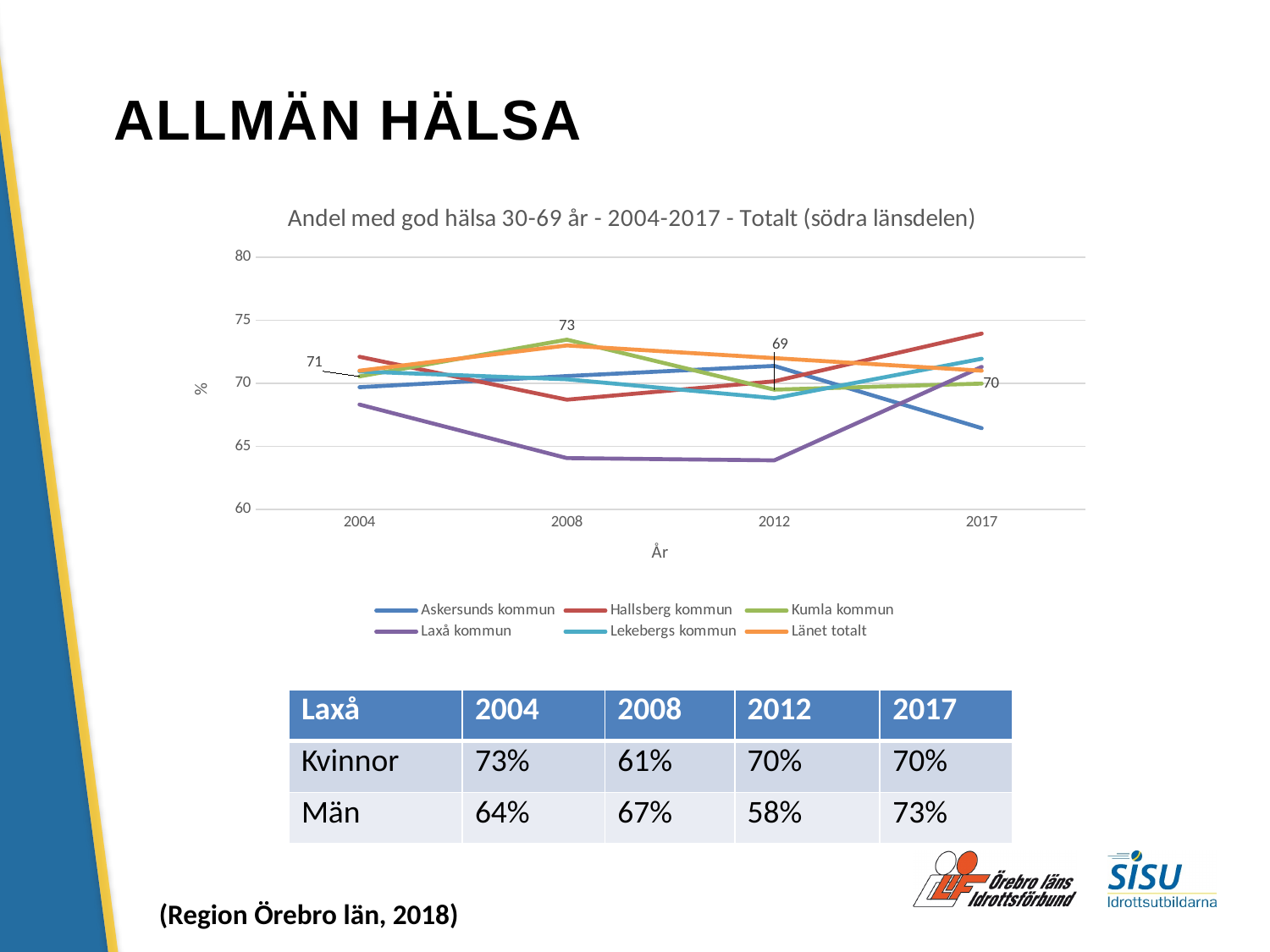
How many series does the chart legend list? 6 Is the value for Laxå kommun in 2012 greater or less than 65? less What is the labelled value for Kumla kommun in 2008? 73 Which series has the lowest value in 2008? Laxå kommun What type of chart is shown on the slide? Line chart What is the labelled value for Kumla kommun in 2012? 69 What is the labelled value for Kumla kommun in 2004? 71 What is the title of the chart? Andel med god hälsa 30-69 år - 2004-2017 - Totalt (södra länsdelen) How many years are plotted along the x axis of the chart? 4 Is the value for Askersunds kommun in 2017 greater or less than 70? less Which series has the highest value in 2017? Hallsberg kommun By how much did the labelled value for Kumla kommun fall from 2008 to 2012? 4